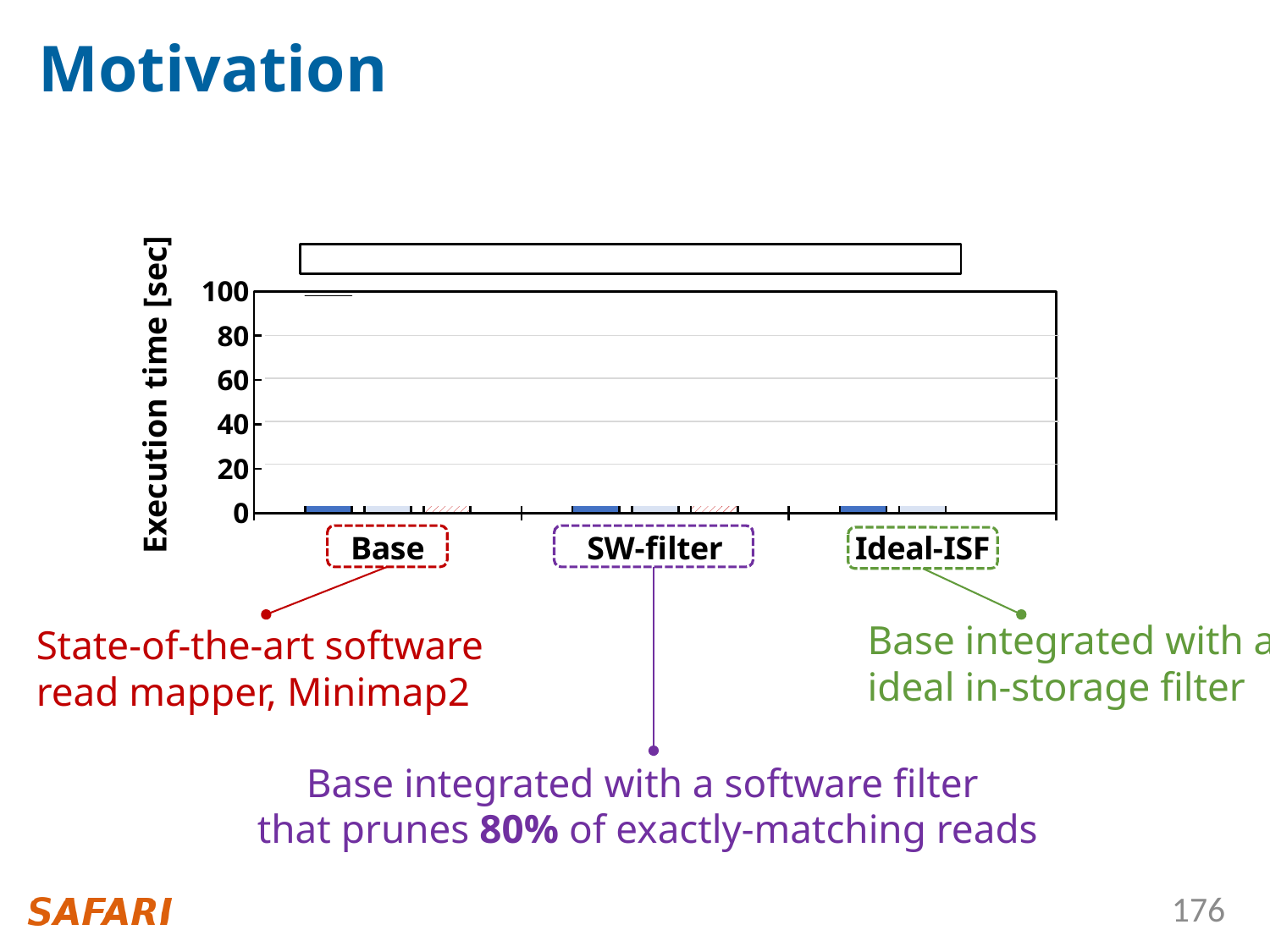
What is the label of the y axis of the chart? Execution time [sec] Which category is labelled last (rightmost) on the x axis of the chart? Ideal-ISF What kind of chart is shown on the slide? bar chart How many categories are labelled on the x axis of the chart? 3 Which category is labelled first (leftmost) on the x axis of the chart? Base What is the highest tick value shown on the y axis of the chart? 100